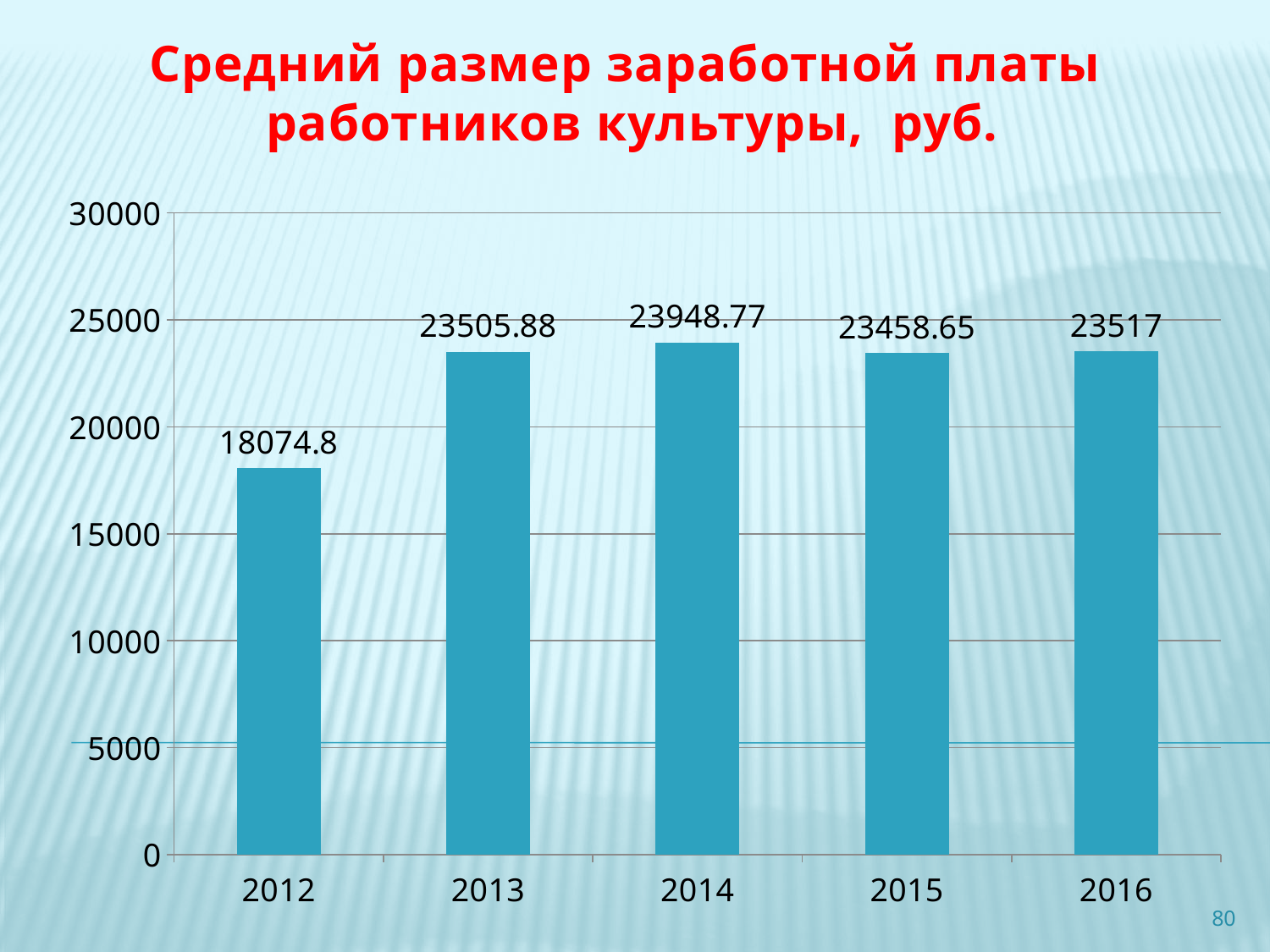
Which year has the highest value? 2014 What is the difference between the values for 2014 and 2012? 5873.97 Which year has the lowest value? 2012 Which is larger, the value for 2013 or the value for 2012? 2013 What kind of chart is shown on the slide? bar chart What is the value shown for 2014? 23948.77 What is the title of the chart? Средний размер заработной платы работников культуры, руб. What is the value shown for 2016? 23517 Is the value for 2012 greater or less than 20000? less What is the difference between the values for 2016 and 2015? 58.35 What is the average salary value shown for 2012? 18074.8 How many years are shown on the x axis? 5